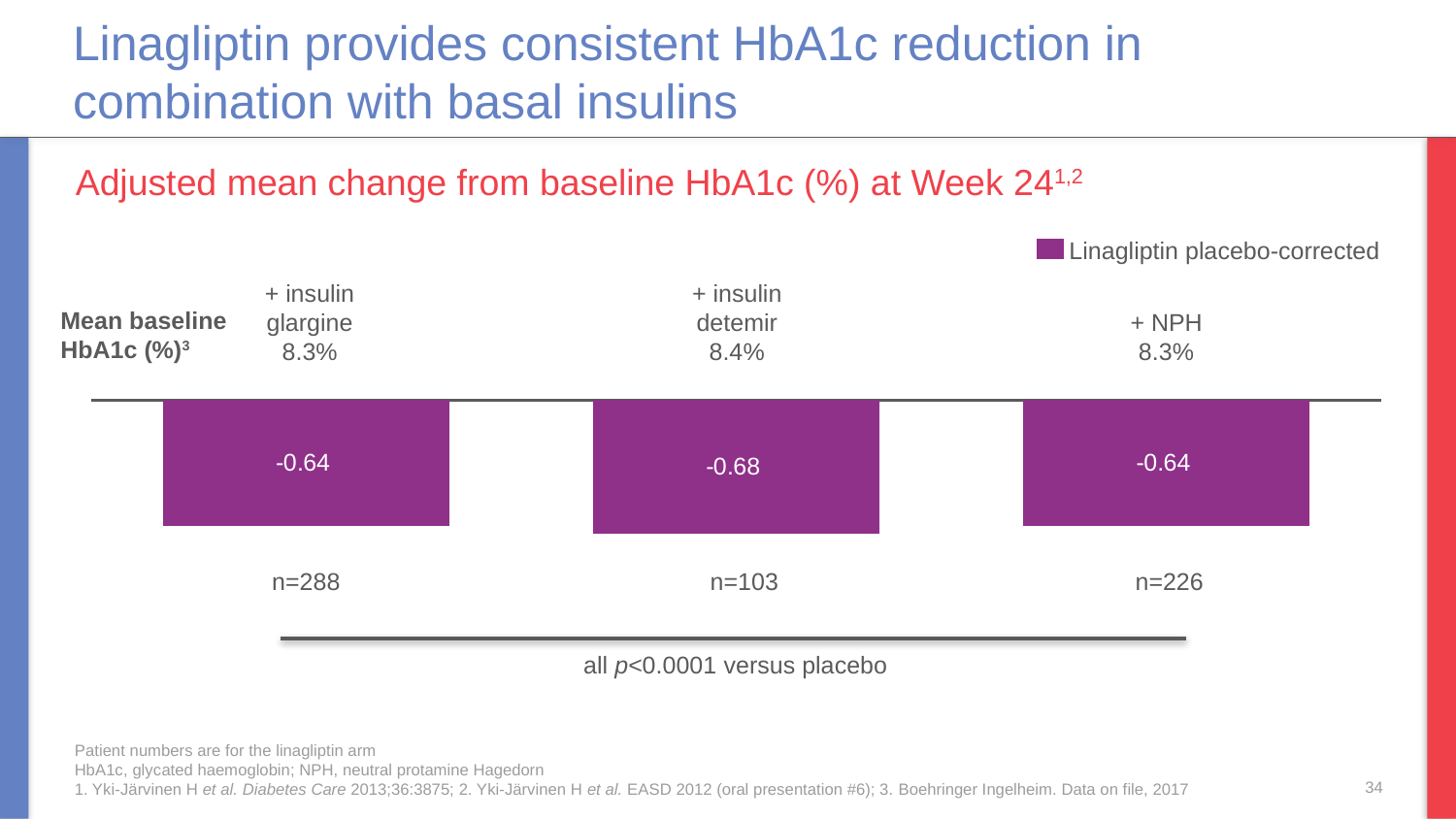
What is the adjusted mean change from baseline HbA1c for linagliptin + insulin detemir? -0.68 What is the adjusted mean change from baseline HbA1c for linagliptin + insulin glargine? -0.64 What is the patient number (n) for the + NPH group? n=226 Is the HbA1c reduction larger for + insulin detemir or + NPH? + insulin detemir Which basal insulin combination shows the largest (most negative) HbA1c change? + insulin detemir How many series does the legend list? 1 What series name is shown in the chart legend? Linagliptin placebo-corrected What kind of chart is shown on the slide? Bar chart How many basal insulin combinations are plotted in the chart? 3 What is the adjusted mean change from baseline HbA1c for linagliptin + NPH? -0.64 What is the mean baseline HbA1c for the + insulin detemir group? 8.4% What is the difference between the HbA1c change for + insulin detemir and + insulin glargine? 0.04